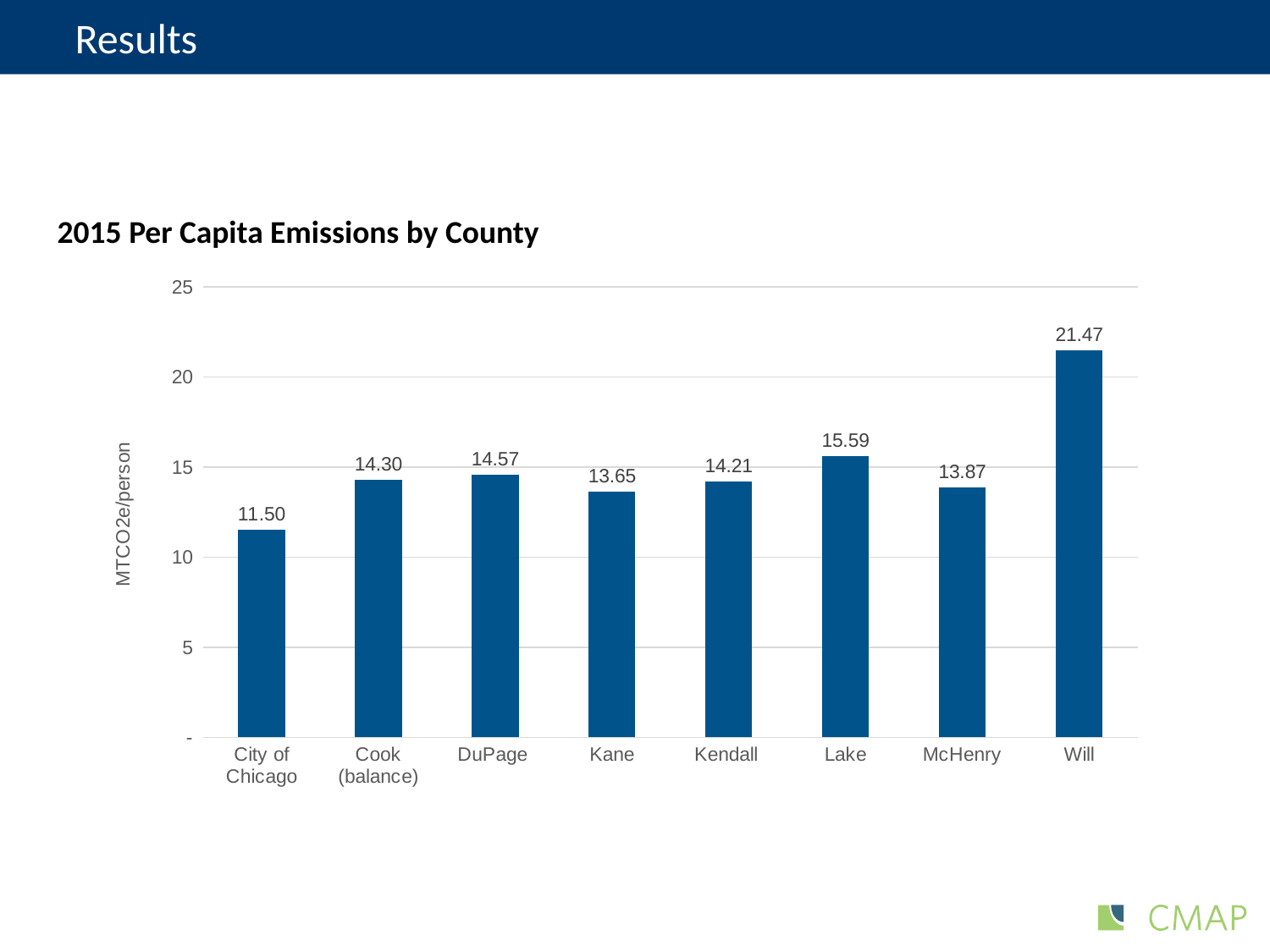
How many categories are shown on the x axis? 8 What kind of chart is shown on the slide? bar chart Which county has the highest per capita emissions? Will Which has higher per capita emissions, DuPage or McHenry? DuPage What is the per capita emissions value for Lake county? 15.59 Which category has the lowest per capita emissions? City of Chicago What is the 2015 per capita emissions value for the City of Chicago? 11.50 What is the 2015 per capita emissions value for Will county? 21.47 What is the label on the y axis of the chart? MTCO2e/person Is the value for Kendall greater or less than 15? less What is the difference in per capita emissions between Lake and Kane? 1.94 What is the difference in per capita emissions between Will and the City of Chicago? 9.97